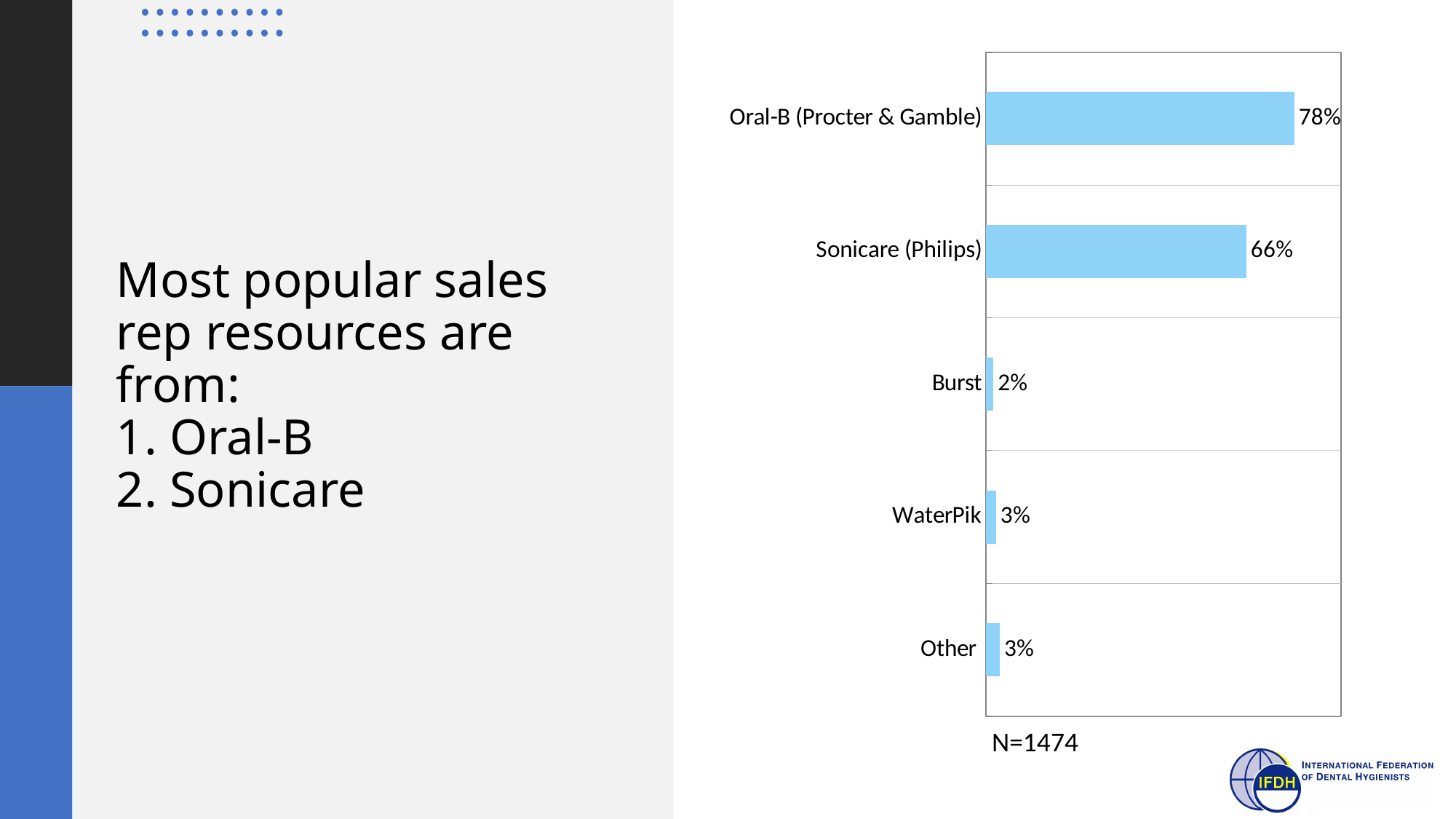
What is the value for Burst? 2% What kind of chart is shown on the slide? Bar chart What is the value for Sonicare (Philips)? 66% What is the value for Oral-B (Procter & Gamble)? 78% Which is larger, the value for WaterPik or the value for Burst? WaterPik Which category has the highest value? Oral-B (Procter & Gamble) Which category has the lowest value? Burst What is the value for WaterPik? 3% What sample size (N) is shown below the chart? N=1474 What is the difference between the values for Oral-B (Procter & Gamble) and Sonicare (Philips)? 12% How many categories are shown in the chart? 5 What is the value for Other? 3%